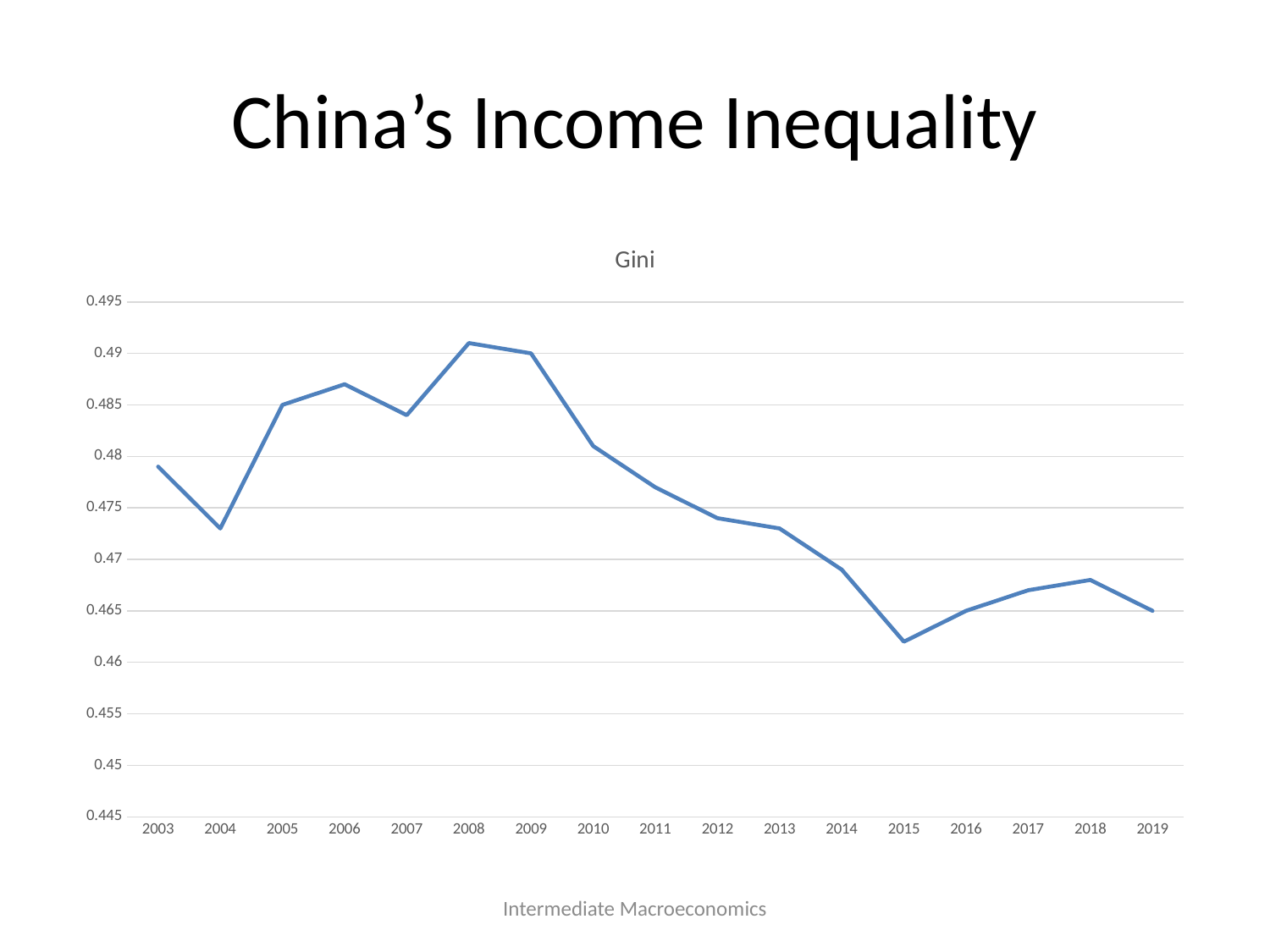
What kind of chart is shown on the slide? line chart Does the Gini value rise or fall from 2009 to 2015? fall Is the Gini value for 2018 greater or less than 0.465? greater In which year is the Gini value lowest? 2015 Is the Gini value for 2003 greater or less than 0.475? greater Which year has the larger Gini value, 2003 or 2004? 2003 What is the Gini value for 2009? 0.49 What is the title of the chart? Gini How many years are plotted on the x axis? 17 In which year is the Gini value highest? 2008 What is the Gini value for 2019? 0.465 Is the Gini value for 2015 greater or less than 0.465? less